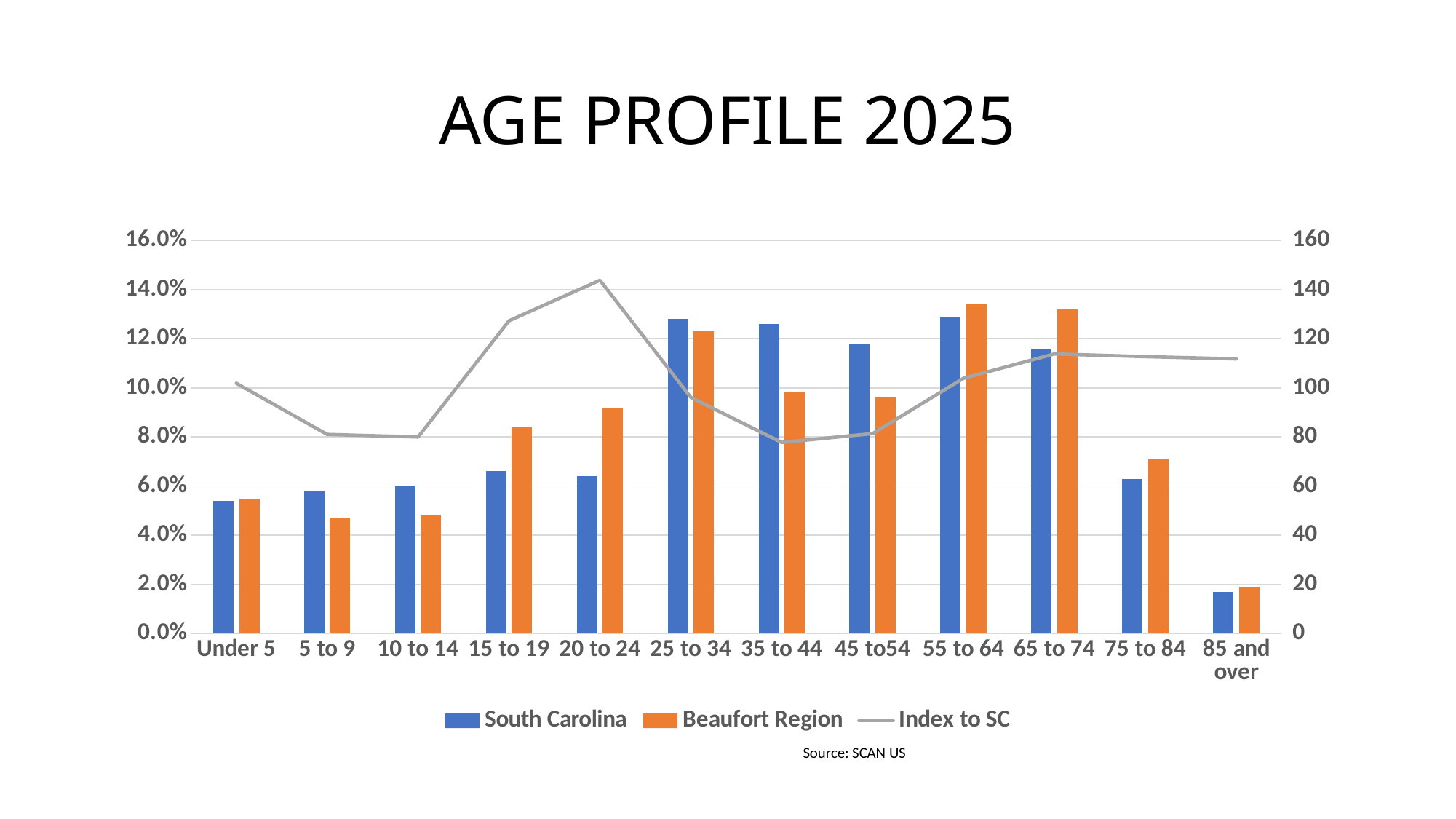
For the 75 to 84 age group, which is larger: South Carolina or Beaufort Region? Beaufort Region Is the South Carolina value for 25 to 34 greater or less than 12.0%? greater For the 5 to 9 age group, which is larger: South Carolina or Beaufort Region? South Carolina Which age category has the lowest Beaufort Region value? 85 and over Which age category has the highest Index to SC value? 20 to 24 How many series does the legend list? 3 Is the Index to SC value for 5 to 9 greater or less than 100? less What is the title of the chart? AGE PROFILE 2025 How many age categories are shown on the x axis? 12 What kind of chart is shown on the slide? A combined bar and line chart Does the Index to SC line rise or fall from Under 5 to 10 to 14? fall